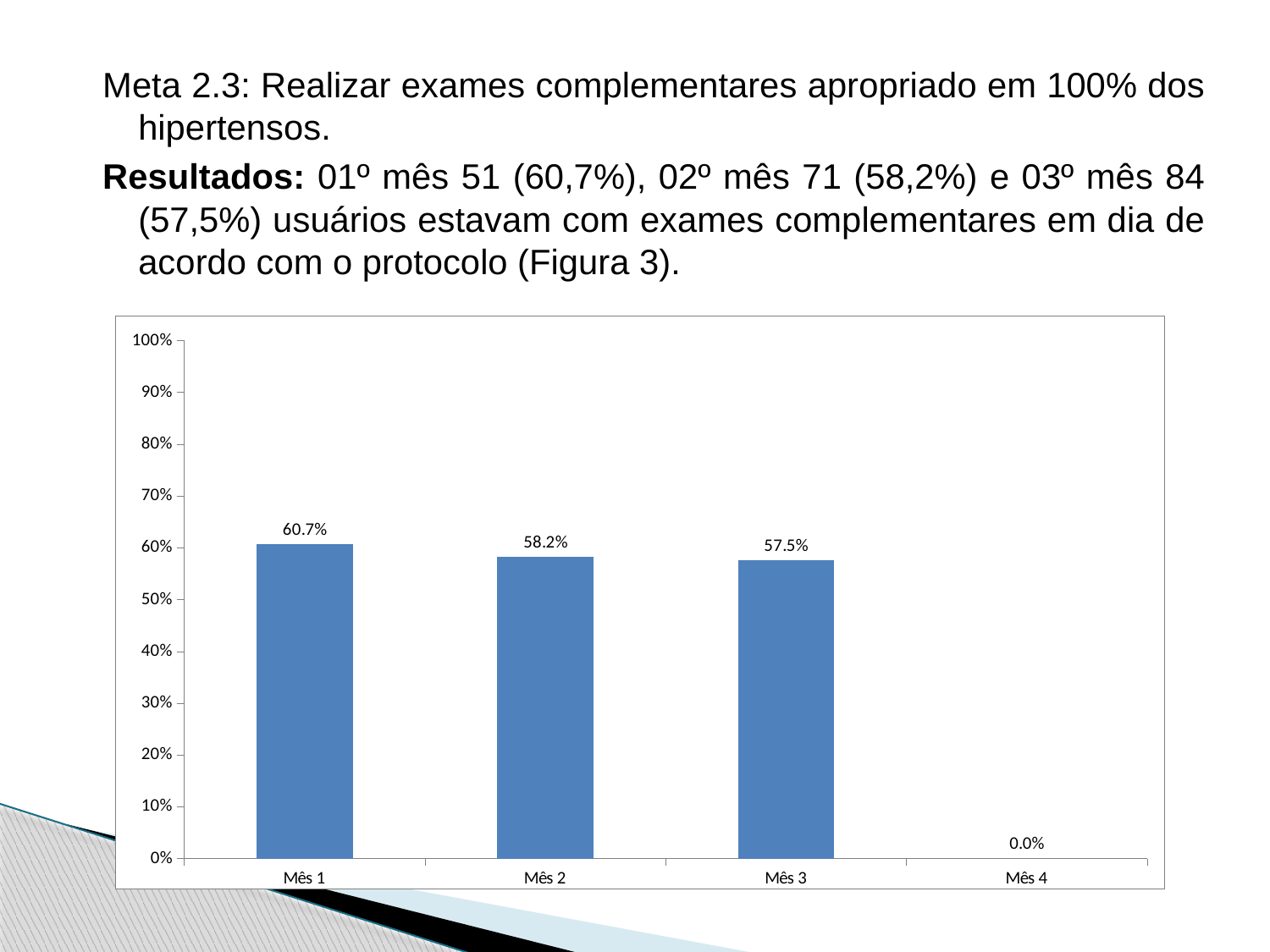
What is the value for Mês 3? 57.5% How many categories are shown on the x axis? 4 Which category has the lowest value? Mês 4 What is the value for Mês 4? 0.0% What is the value for Mês 2? 58.2% Which category has the highest value? Mês 1 What kind of chart is shown on the slide? bar chart Do the values rise or fall from Mês 1 to Mês 3? fall What is the difference between the values for Mês 1 and Mês 3? 3.2% Which is larger, the value for Mês 2 or the value for Mês 3? Mês 2 What is the value for Mês 1? 60.7% Is the value for Mês 2 greater or less than 50%? greater